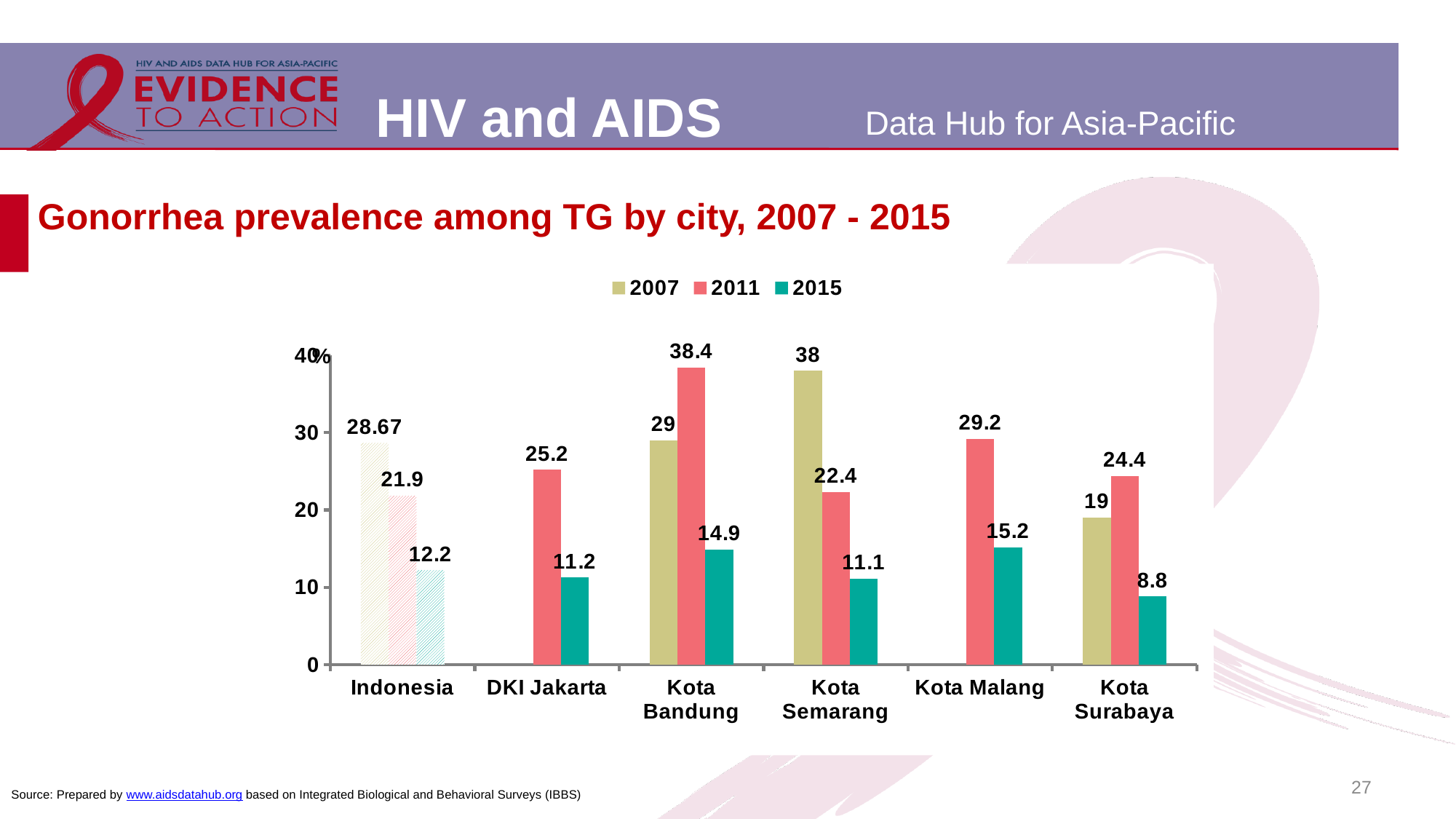
What is the 2007 value for Indonesia? 28.67 What is the difference between the 2011 and 2015 values for Kota Malang? 14 Which is larger, the 2015 value for Kota Bandung or the 2015 value for Kota Semarang? Kota Bandung Is the 2011 value for DKI Jakarta greater or less than 20? greater What is the 2011 value for Kota Bandung? 38.4 Which category has the lowest 2015 value? Kota Surabaya How many series does the legend list? 3 How many categories are shown on the x axis? 6 Which city has the highest 2011 value? Kota Bandung What kind of chart is shown on the slide? bar chart What is the 2007 value for Kota Semarang? 38 What is the 2015 value for Kota Surabaya? 8.8